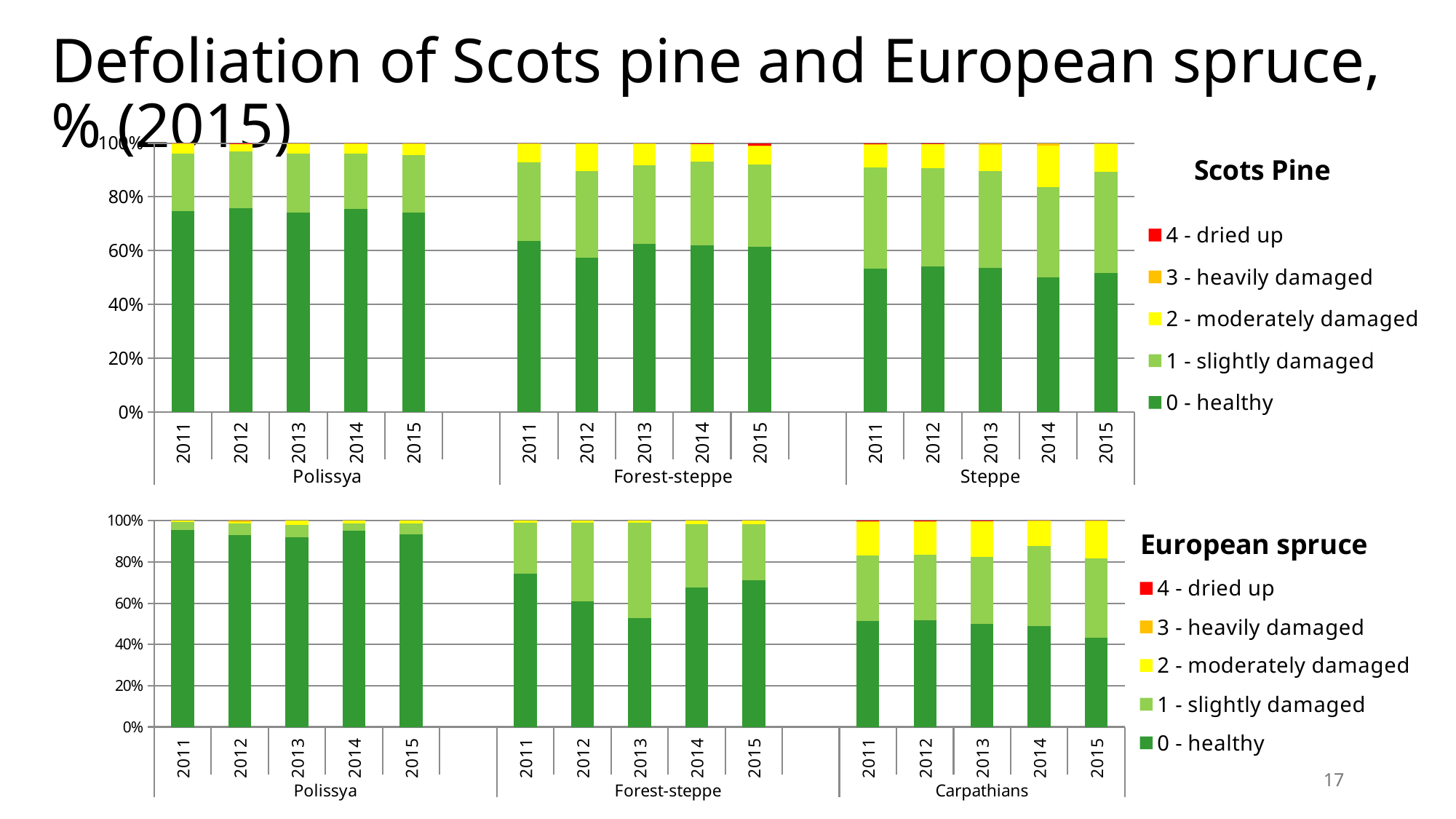
What kind of chart is the Scots Pine chart at the top of the slide? stacked bar chart Which region appears in the European spruce chart but not in the Scots Pine chart? Carpathians How many bars are plotted in the Scots Pine chart? 15 How many series does the legend of the European spruce chart list? 5 In the Scots Pine chart, which legend entry is shown in yellow? 2 - moderately damaged In the Scots Pine chart, is the '0 - healthy' share for Steppe in 2014 greater or less than 60%? less In the Scots Pine chart, which has the larger '0 - healthy' share in 2011: Polissya or Steppe? Polissya In the European spruce chart, is the '0 - healthy' share for Polissya in 2011 greater or less than 80%? greater In the European spruce chart, which has the larger '0 - healthy' share in 2013: Polissya or Carpathians? Polissya In the European spruce chart, is the '0 - healthy' share for Carpathians in 2015 greater or less than 60%? less How many regions are shown along the x axis of the European spruce chart? 3